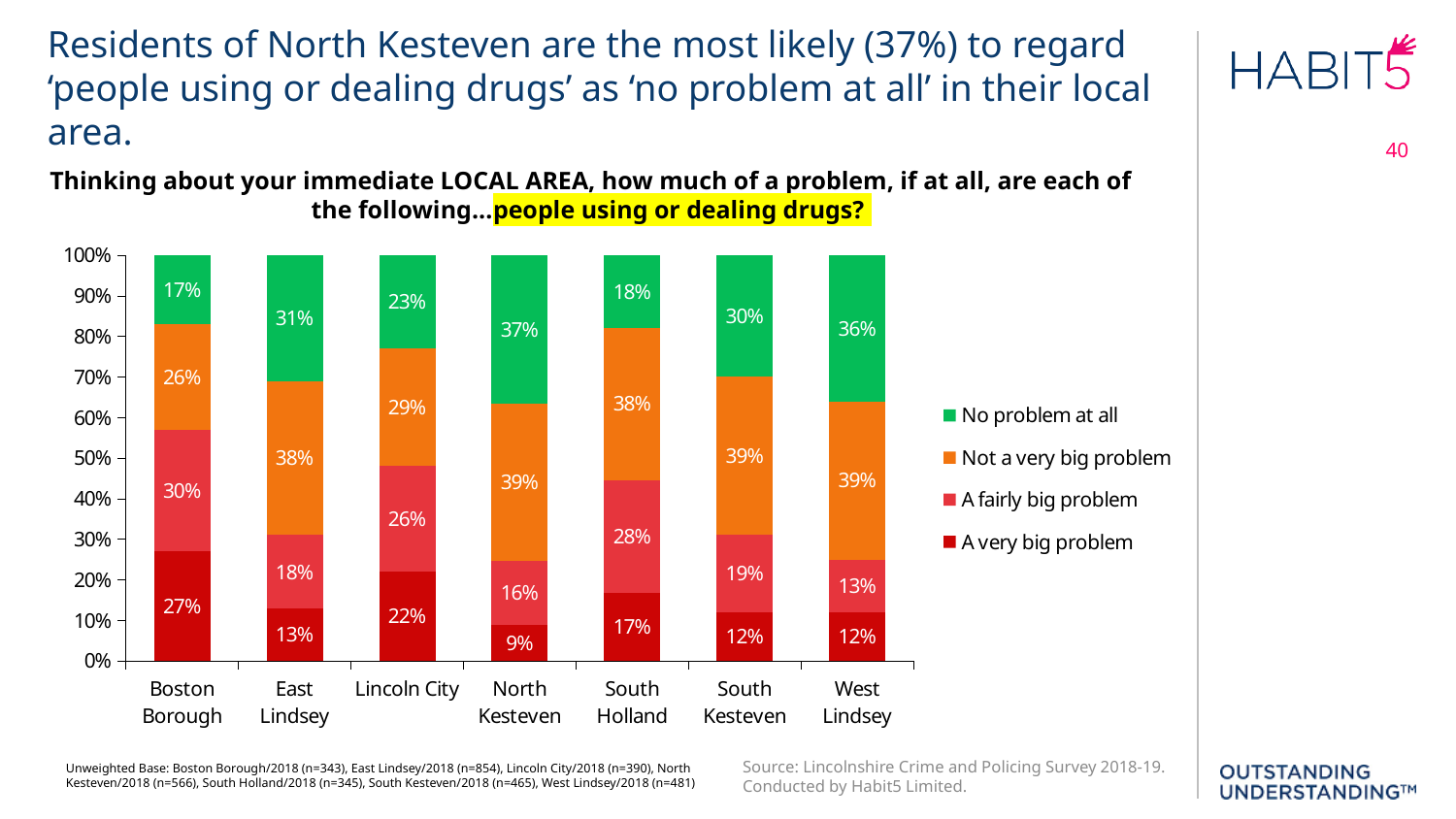
What kind of chart is shown on the slide? Stacked bar chart Which has a larger 'No problem at all' share, West Lindsey or Lincoln City? West Lindsey Which area has the highest share for 'No problem at all'? North Kesteven Which area has the lowest share for 'A very big problem'? North Kesteven What colour represents 'No problem at all' in the chart? Green Which area has the highest share for 'A very big problem'? Boston Borough How many areas are shown on the x axis? 7 What is the difference between the 'A very big problem' values for Boston Borough and North Kesteven? 18 percentage points What is the value for 'A very big problem' in Boston Borough? 27% What percentage of North Kesteven residents said 'No problem at all'? 37% How many series does the legend list? 4 What is the value for 'Not a very big problem' in South Holland? 38%